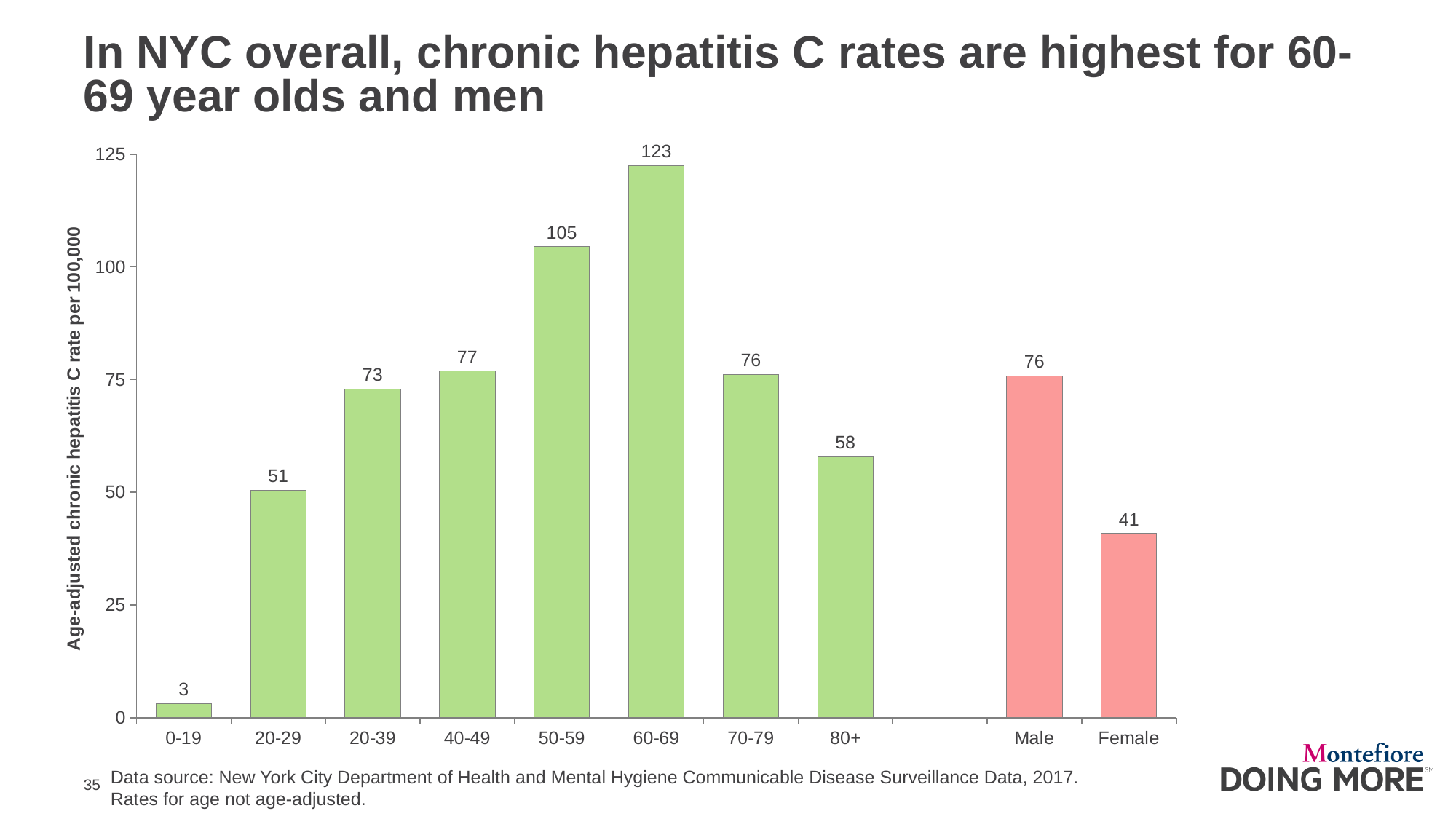
What is the chronic hepatitis C rate for Female? 41 Which has a higher chronic hepatitis C rate, the 80+ age group or the 20-29 age group? 80+ Which age group has the lowest chronic hepatitis C rate? 0-19 What is the chronic hepatitis C rate for the 60-69 age group? 123 How many bars are plotted on the chart? 10 What type of chart is shown on the slide? Bar chart What is the chronic hepatitis C rate for the 0-19 age group? 3 Is the value for the 50-59 age group greater or less than 100? greater Which age group has the highest chronic hepatitis C rate? 60-69 What is the difference between the rates for the 60-69 and 50-59 age groups? 18 What is the label of the vertical axis? Age-adjusted chronic hepatitis C rate per 100,000 What is the difference between the Male and Female chronic hepatitis C rates? 35